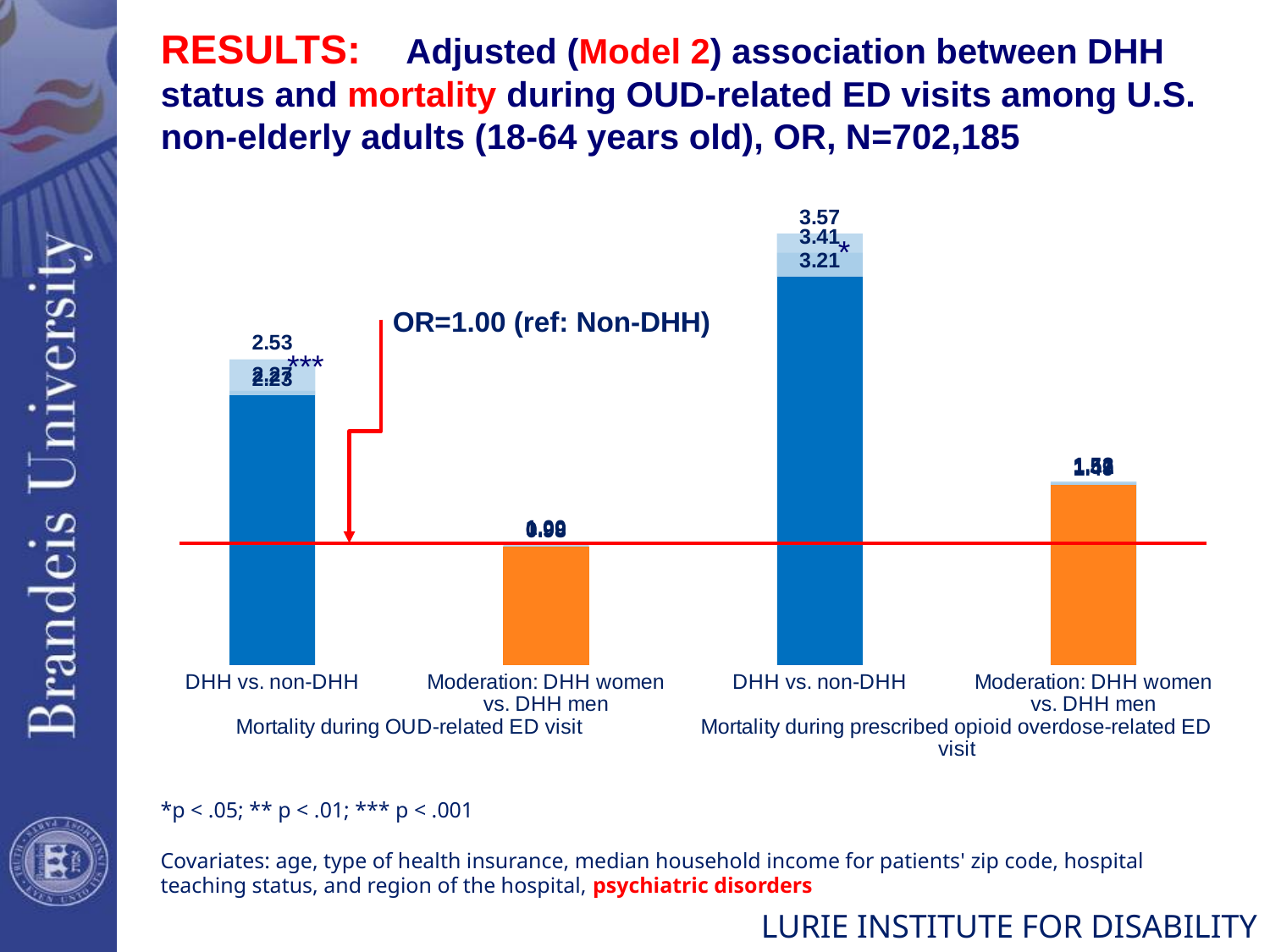
Which bar is the shortest in the chart? Moderation: DHH women vs. DHH men (Mortality during OUD-related ED visit) What reference value does the red horizontal line in the chart represent? OR=1.00 (ref: Non-DHH) Is the value for Moderation: DHH women vs. DHH men for mortality during prescribed opioid overdose-related ED visit greater or less than 1.00? greater How many bars are plotted in the chart? 4 Which is larger: the DHH vs. non-DHH bar for mortality during OUD-related ED visit or the DHH vs. non-DHH bar for mortality during prescribed opioid overdose-related ED visit? DHH vs. non-DHH for mortality during prescribed opioid overdose-related ED visit What is the lowest value printed above the DHH vs. non-DHH bar for mortality during prescribed opioid overdose-related ED visit? 3.21 What is the highest value printed above the DHH vs. non-DHH bar for mortality during prescribed opioid overdose-related ED visit? 3.57 What is the difference between the highest (3.57) and lowest (3.21) values printed above the DHH vs. non-DHH bar for mortality during prescribed opioid overdose-related ED visit? 0.36 What is the highest value printed above the DHH vs. non-DHH bar for mortality during OUD-related ED visit? 2.53 Which bar is the tallest in the chart? DHH vs. non-DHH (Mortality during prescribed opioid overdose-related ED visit) What kind of chart is shown on the slide? bar chart What colour are the Moderation: DHH women vs. DHH men bars? orange